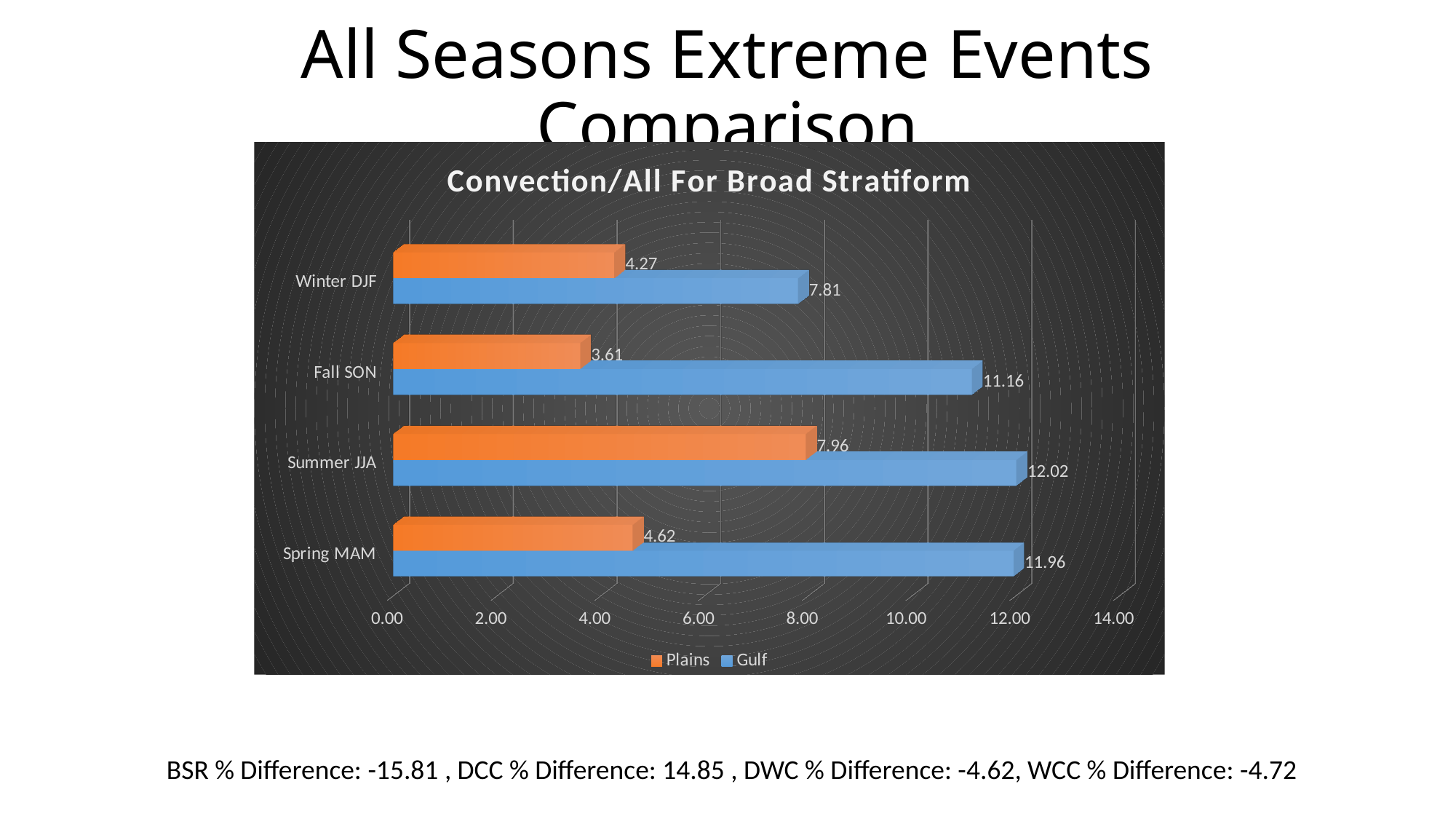
Which season has the highest Gulf value? Summer JJA What kind of chart is shown? Bar chart Which is larger for Spring MAM, the Plains value or the Gulf value? Gulf How many series does the legend list? 2 What is the Plains value for Summer JJA? 7.96 How many seasons are shown on the chart? 4 What is the Gulf value for Spring MAM? 11.96 What is the difference between the Gulf and Plains values for Winter DJF? 3.54 What is the Plains value for Winter DJF? 4.27 Which season has the lowest Plains value? Fall SON What is the title of the chart? Convection/All For Broad Stratiform What is the Gulf value for Fall SON? 11.16